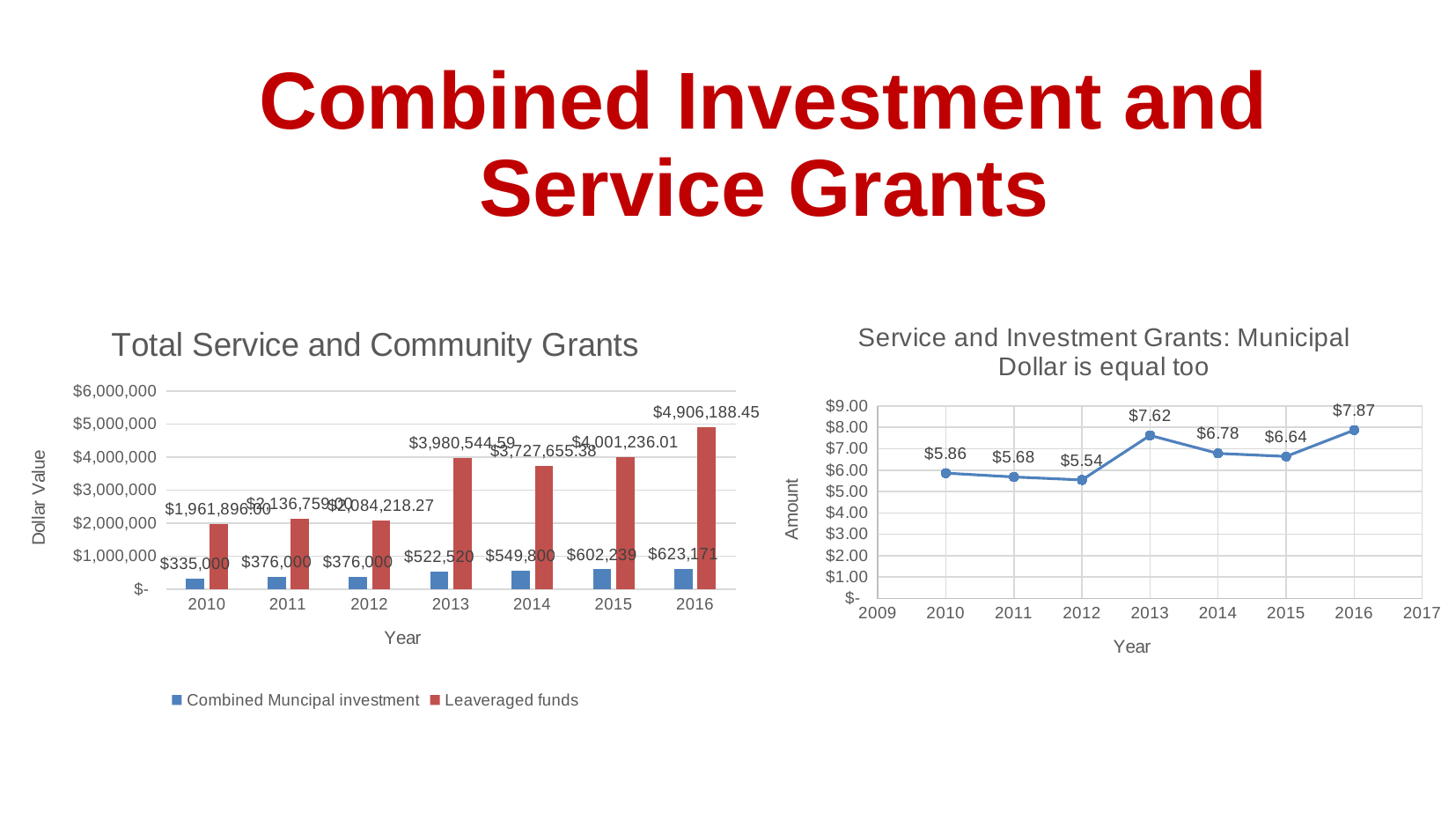
What kind of chart is the "Service and Investment Grants: Municipal Dollar is equal too" chart? line chart In the "Service and Investment Grants: Municipal Dollar is equal too" chart, what is the difference between the 2016 and 2015 values? $1.23 How many series does the legend of the "Total Service and Community Grants" chart list? 2 In the "Total Service and Community Grants" chart, which year has the larger Leaveraged funds value, 2013 or 2014? 2013 In the "Service and Investment Grants: Municipal Dollar is equal too" chart, what is the value for 2013? $7.62 In the "Total Service and Community Grants" chart, what is the Leaveraged funds value for 2016? $4,906,188.45 In the "Service and Investment Grants: Municipal Dollar is equal too" chart, which year has the highest value? 2016 In the "Total Service and Community Grants" chart, which year has the lowest Combined Muncipal investment value? 2010 In the "Total Service and Community Grants" chart, what is the Combined Muncipal investment value for 2013? $522,520 In the "Total Service and Community Grants" chart, how much larger is the Combined Muncipal investment in 2016 than in 2015? $20,932 What kind of chart is the "Total Service and Community Grants" chart? bar chart In the "Total Service and Community Grants" chart, which year has the highest Leaveraged funds value? 2016